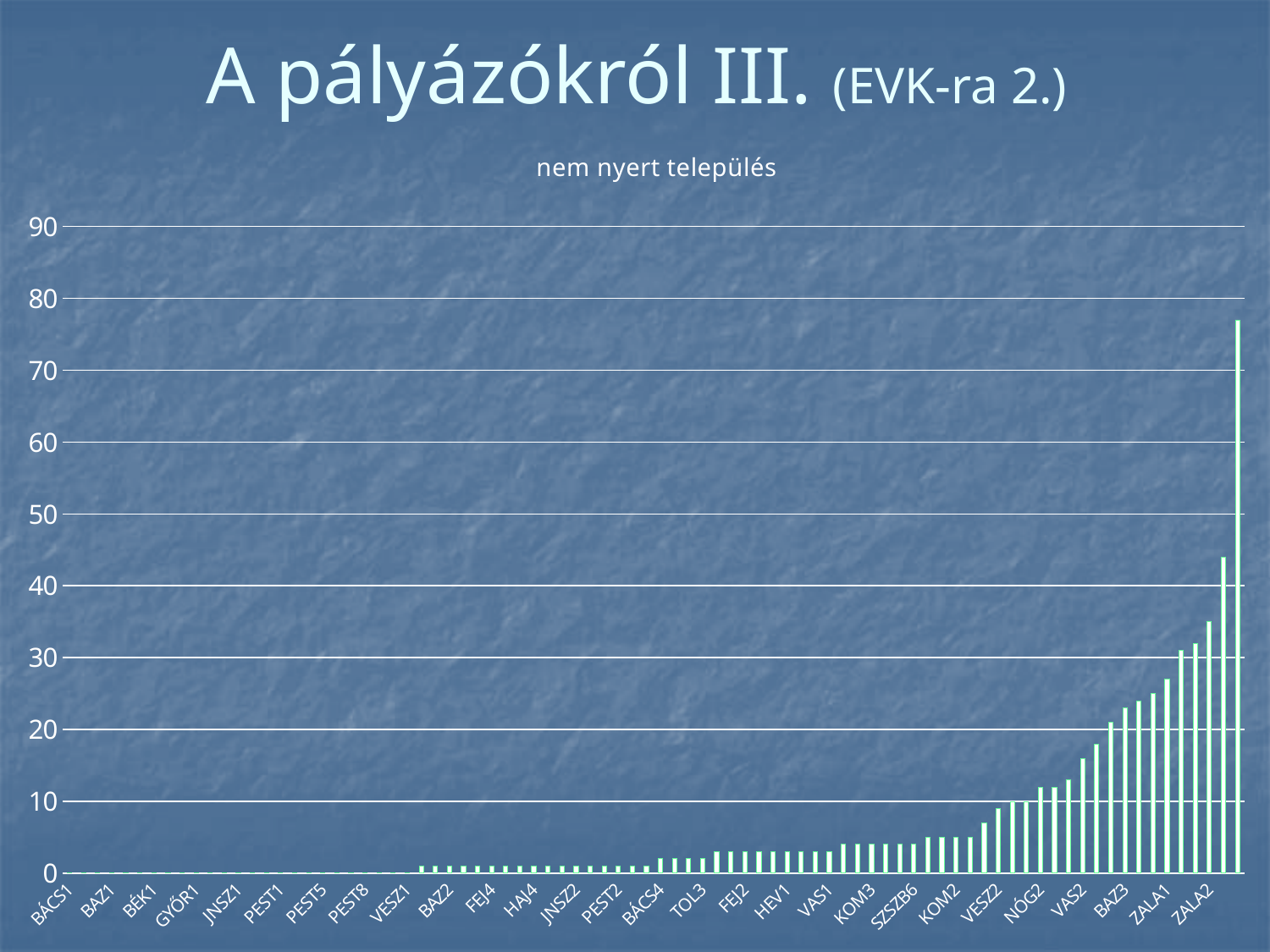
Is the value for ZALA1 greater or less than 10? greater Is the value for KOM2 greater or less than 20? less What is the title of the chart? nem nyert település Do the bar values generally rise or fall from left to right along the x axis? rise Is the value for VESZ2 greater or less than 30? less What kind of chart is shown on the slide? bar chart Which has the larger value, ZALA2 or BÁCS1? ZALA2 What is the highest value shown on the vertical axis? 90